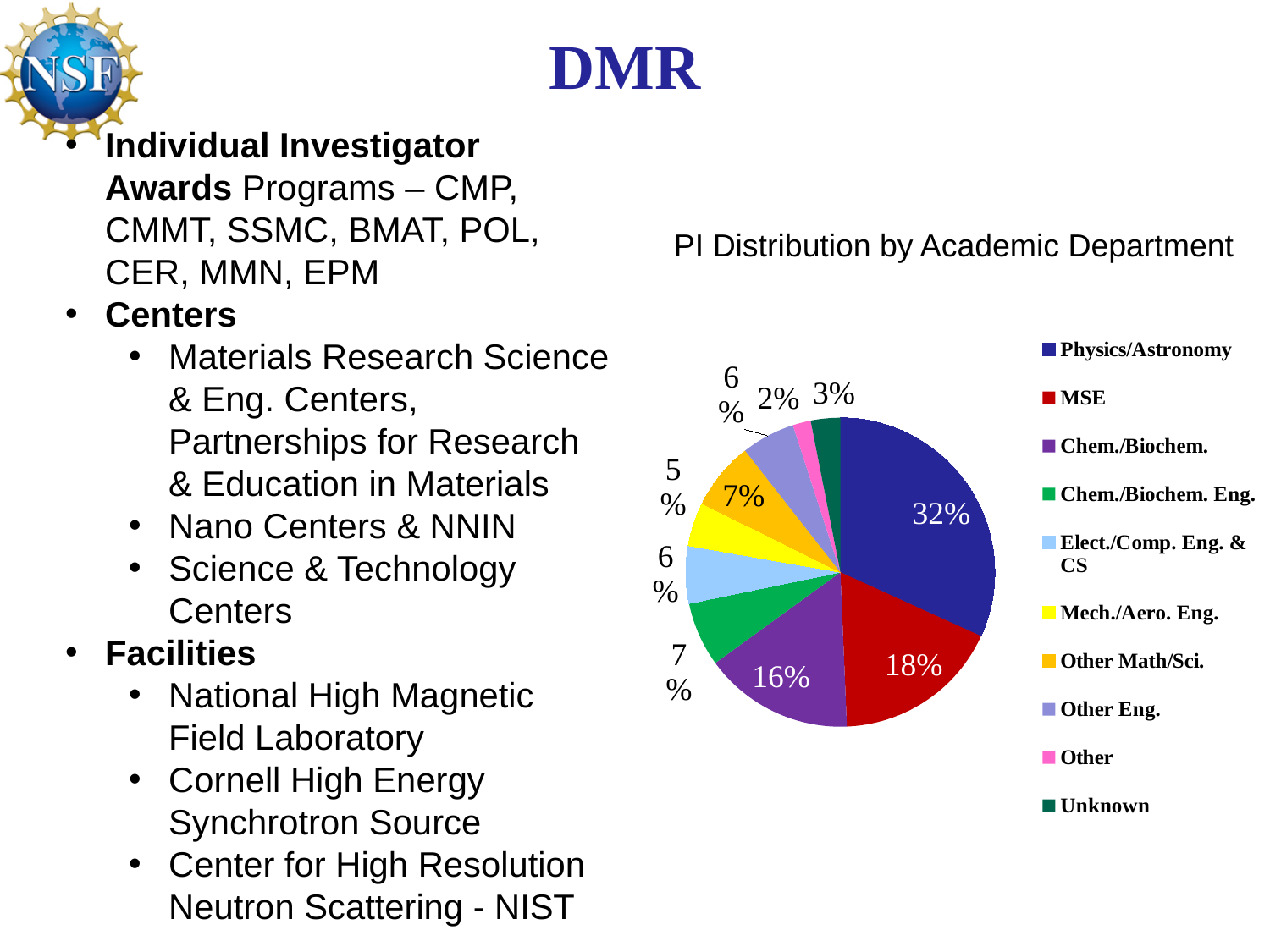
What percentage of PIs are in MSE? 18% How many categories does the legend list? 10 Which has a larger share of PIs, MSE or Chem./Biochem.? MSE What percentage of PIs are in Chem./Biochem.? 16% Which academic department has the largest share of PIs? Physics/Astronomy What percentage of PIs are in Physics/Astronomy? 32% What kind of chart is shown on the slide? pie chart How many percentage points larger is the Physics/Astronomy share than the MSE share? 14 What percentage of PIs are in Other Math/Sci.? 7% What is the title of the chart? PI Distribution by Academic Department Which category has the smallest share of PIs? Other What percentage of PIs are listed as Unknown? 3%